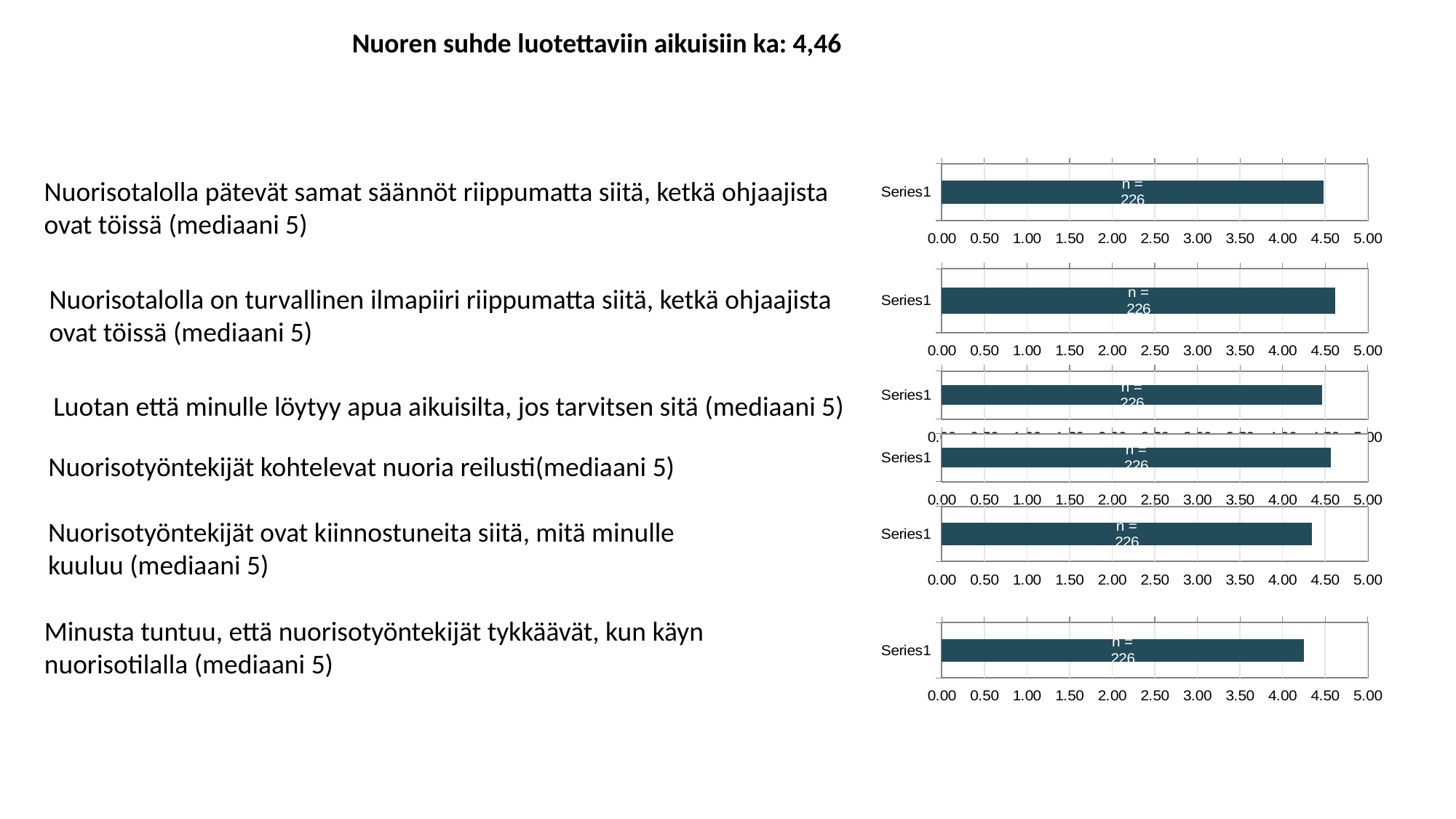
In the second chart from the top (next to 'Nuorisotalolla on turvallinen ilmapiiri...'), is the value of the Series1 bar greater or less than 4.50? greater In the top chart, is the value of the Series1 bar greater or less than 4.00? greater What data label is printed on the bar in the bottom chart (next to 'Minusta tuntuu, että nuorisotyöntekijät tykkäävät...')? n = 226 In the bottom chart (next to 'Minusta tuntuu, että nuorisotyöntekijät tykkäävät...'), is the value of the Series1 bar greater or less than 4.50? less In the top chart (next to 'Nuorisotalolla pätevät samat säännöt...'), how many bars are plotted? 1 Which bar is longer: the one in the second chart from the top ('Nuorisotalolla on turvallinen ilmapiiri...') or the one in the bottom chart ('Minusta tuntuu, että nuorisotyöntekijät tykkäävät...')? the second chart from the top What is the maximum value shown on the horizontal axis of the charts? 5.00 How many separate bar charts are shown on the slide? 6 What series name is shown on the vertical axis of each chart? Series1 What kind of chart is used for each of the six small charts on the right of the slide? bar chart